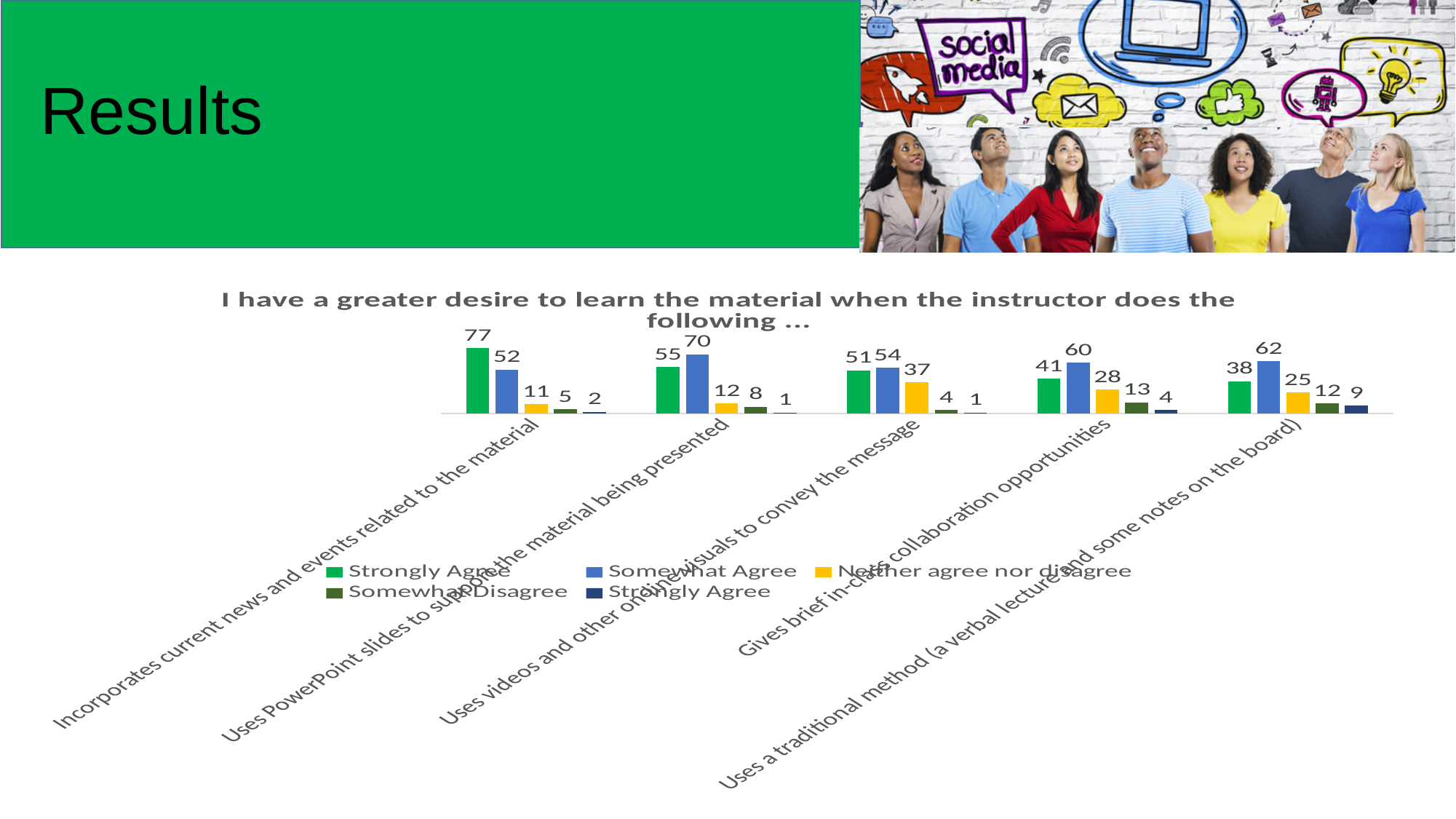
What is the difference between the Somewhat Agree and Strongly Agree values for "Uses a traditional method (a verbal lecture and some notes on the board)"? 24 Does the Strongly Agree value rise or fall across the categories from left to right? Fall What is the Somewhat Agree value for "Uses PowerPoint slides to support the material being presented"? 70 How many series does the legend list? 5 What is the Somewhat Disagree value for "Gives brief in-class collaboration opportunities"? 13 What kind of chart is shown on the slide? Bar chart What is the Strongly Agree value for "Incorporates current news and events related to the material"? 77 Which category has the lowest Strongly Agree value? Uses a traditional method (a verbal lecture and some notes on the board) Which category has the highest Strongly Agree value? Incorporates current news and events related to the material Which is larger for "Gives brief in-class collaboration opportunities": the Strongly Agree value or the Somewhat Agree value? Somewhat Agree What is the Neither agree nor disagree value for "Uses videos and other online visuals to convey the message"? 37 How many categories are shown on the x axis? 5